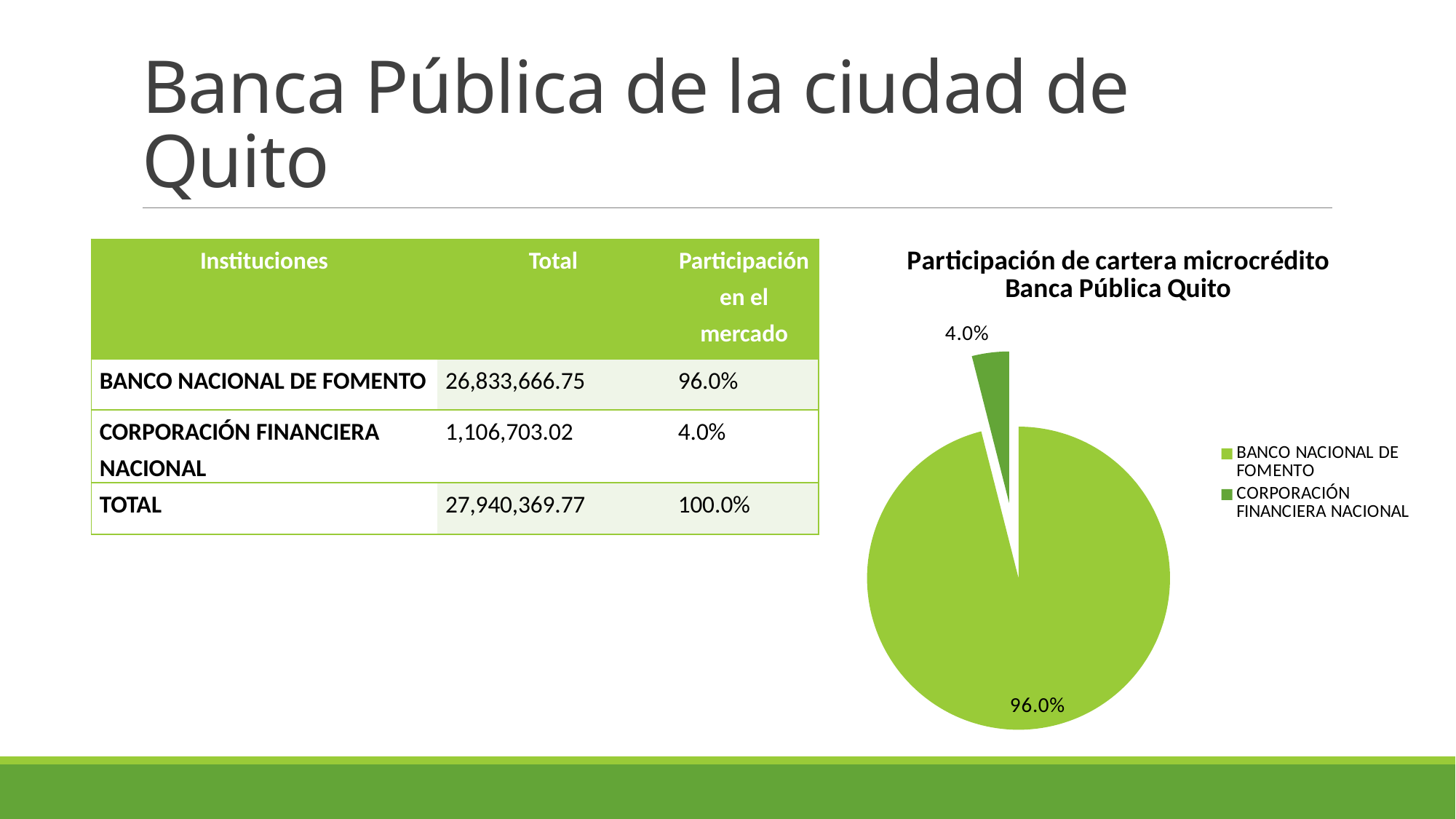
What share of the pie does BANCO NACIONAL DE FOMENTO hold? 96.0% Which institution has the smallest slice of the pie? CORPORACIÓN FINANCIERA NACIONAL What is the difference in percentage points between the BANCO NACIONAL DE FOMENTO slice and the CORPORACIÓN FINANCIERA NACIONAL slice? 92.0 percentage points How many slices does the pie chart have? 2 How many entries does the legend list? 2 What kind of chart is shown on the slide? Pie chart What share of the pie does CORPORACIÓN FINANCIERA NACIONAL hold? 4.0% Which slice is larger, BANCO NACIONAL DE FOMENTO or CORPORACIÓN FINANCIERA NACIONAL? BANCO NACIONAL DE FOMENTO Which legend entry is shown in the darker green colour? CORPORACIÓN FINANCIERA NACIONAL What is the title of the chart? Participación de cartera microcrédito Banca Pública Quito Which institution has the largest slice of the pie? BANCO NACIONAL DE FOMENTO